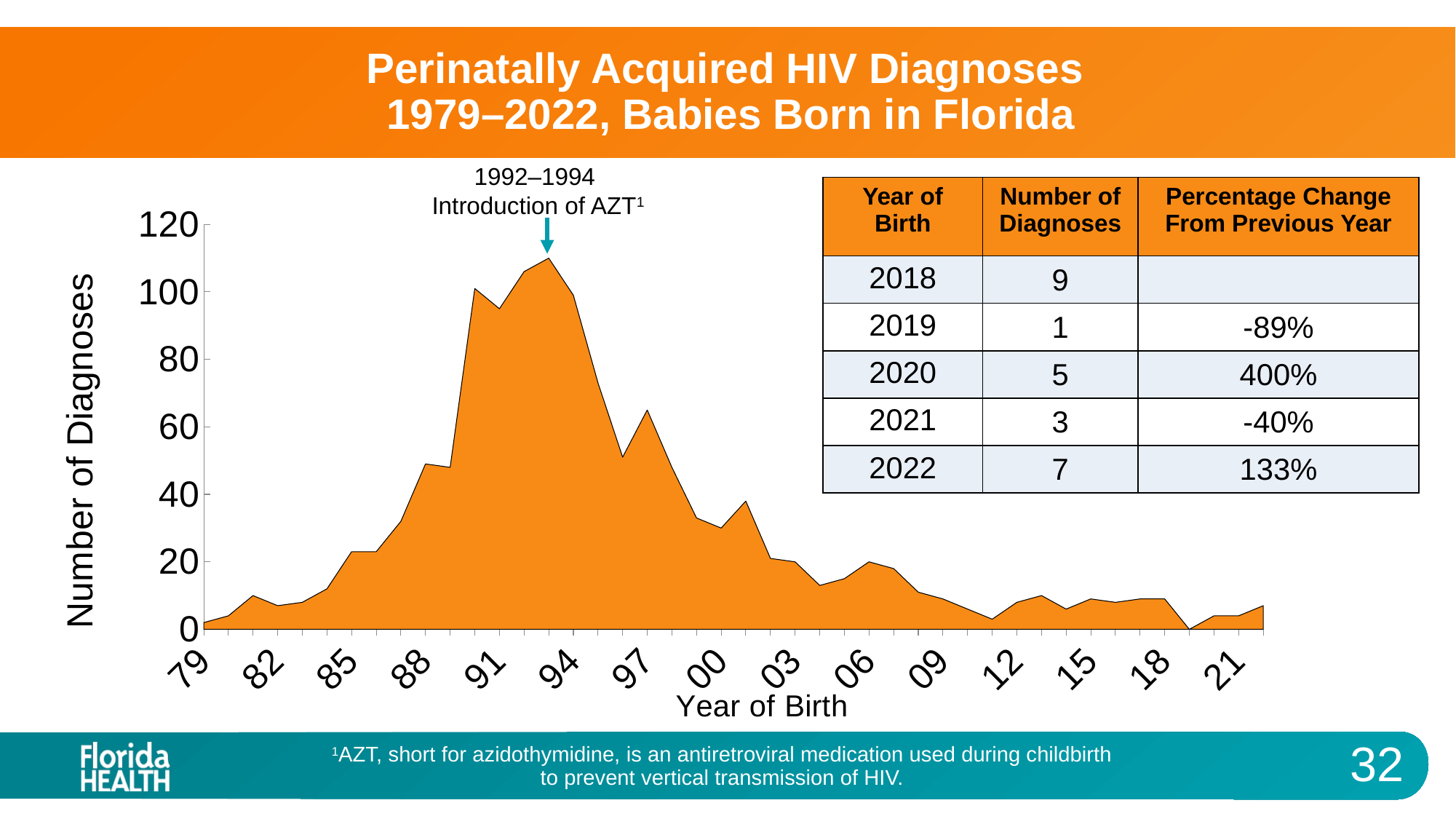
What event does the arrow annotation above the peak of the chart mark? 1992–1994 Introduction of AZT Is the number of diagnoses for babies born in 1985 greater or less than 40? less Which year had more diagnoses, 2020 or 2021? 2020 According to the table, how many perinatally acquired HIV diagnoses were there for babies born in 2020? 5 According to the table, how many perinatally acquired HIV diagnoses were there for babies born in 2022? 7 From 1997 to 2012, do the number of diagnoses generally rise or fall? fall What is the percentage change from the previous year shown for 2020? 400% What kind of chart is used to show the number of perinatally acquired HIV diagnoses by year of birth? Area chart Among the years 2018 to 2022 listed in the table, which year had the most diagnoses? 2018 Among the years 2018 to 2022 listed in the table, which year had the fewest diagnoses? 2019 Is the peak value of the chart greater or less than 100? greater What is the difference in the number of diagnoses between 2018 and 2019? 8